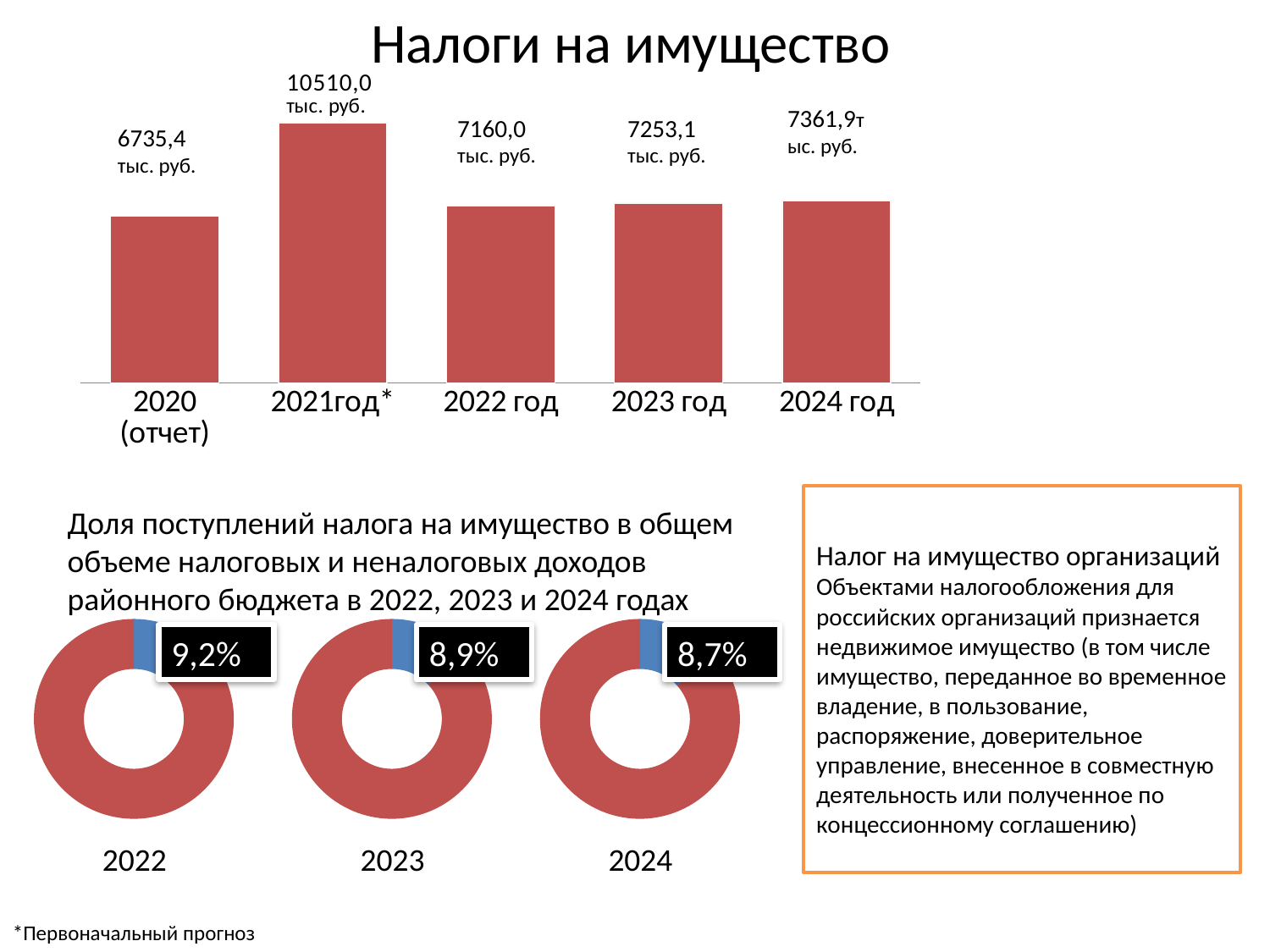
In the bar chart 'Налоги на имущество', what is the value for 2024 год? 7361,9 тыс. руб. In the bar chart 'Налоги на имущество', which is larger: the value for 2023 год or the value for 2022 год? 2023 год In the donut charts at the bottom of the slide, what share is shown for 2023? 8,9% In the donut charts at the bottom of the slide, which year has the highest share? 2022 In the bar chart 'Налоги на имущество', which year has the lowest value? 2020 (отчет) How many bars are in the bar chart 'Налоги на имущество'? 5 What type of chart is the top chart 'Налоги на имущество'? Bar chart In the bar chart 'Налоги на имущество', what is the value for 2021год*? 10510,0 тыс. руб. In the bar chart 'Налоги на имущество', what is the difference between the values for 2024 год and 2022 год? 201,9 тыс. руб. In the bar chart 'Налоги на имущество', which year has the highest value? 2021год* In the bar chart 'Налоги на имущество', what is the value for 2020 (отчет)? 6735,4 тыс. руб. In the bar chart 'Налоги на имущество', what is the difference between the values for 2021год* and 2020 (отчет)? 3774,6 тыс. руб.